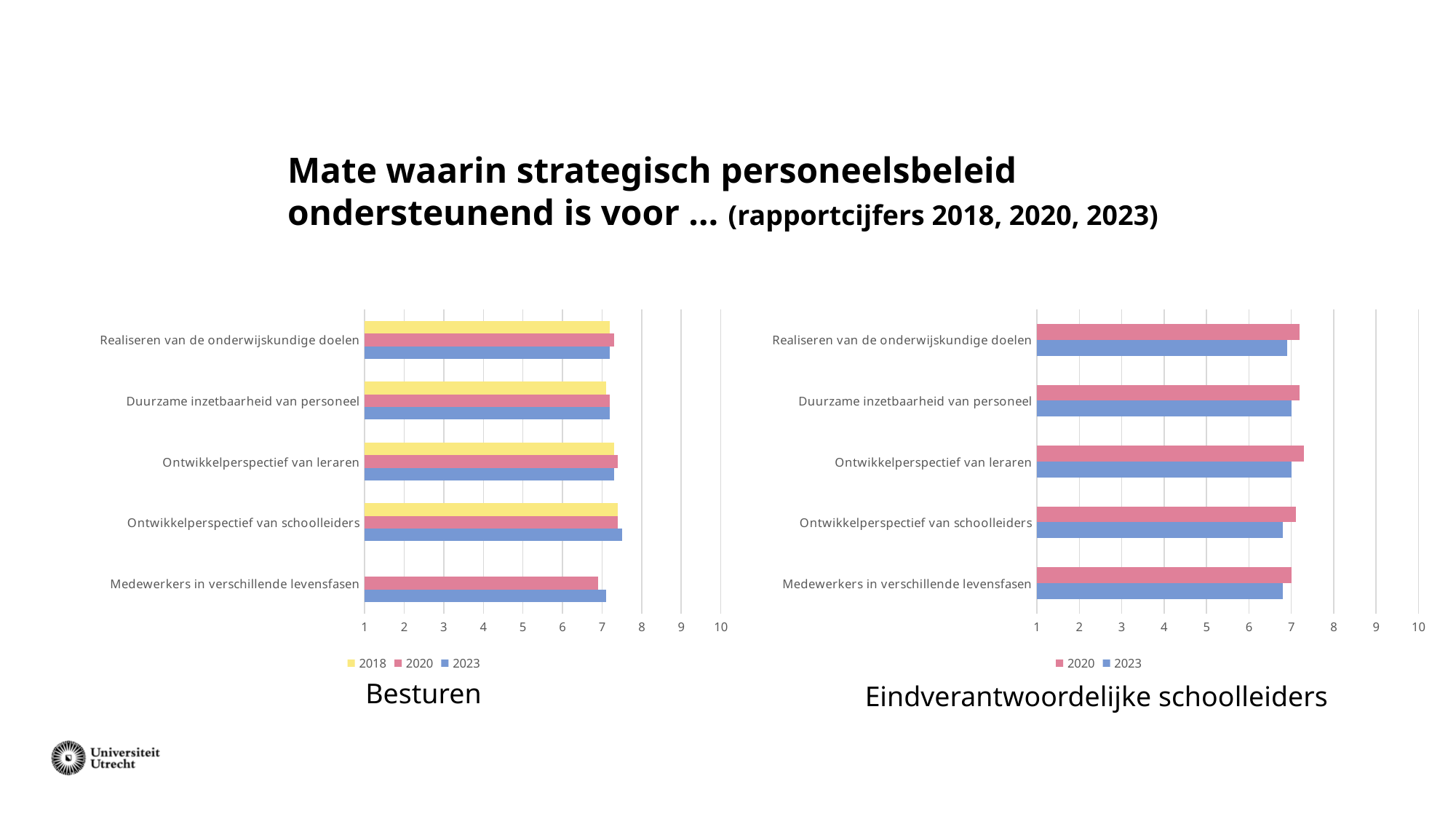
How many series does the legend of the Eindverantwoordelijke schoolleiders chart list? 2 Which years are listed in the legend of the Eindverantwoordelijke schoolleiders chart? 2020 and 2023 In the Eindverantwoordelijke schoolleiders chart, which is larger for Ontwikkelperspectief van leraren: the 2020 value or the 2023 value? 2020 In the Besturen chart, which category has the lowest 2020 value? Medewerkers in verschillende levensfasen In the Besturen chart, which category has no 2018 bar? Medewerkers in verschillende levensfasen In the Besturen chart, is the 2023 value for Ontwikkelperspectief van schoolleiders greater or less than 8? less In the Eindverantwoordelijke schoolleiders chart, is the 2020 value for Ontwikkelperspectief van leraren greater or less than 6? greater How many categories are shown on the Eindverantwoordelijke schoolleiders chart? 5 What is the highest value shown on the x axis of the Besturen chart? 10 What kind of chart is the Besturen chart on the left? bar chart In the Besturen chart, which is larger for Medewerkers in verschillende levensfasen: the 2020 value or the 2023 value? 2023 How many series does the legend of the Besturen chart list? 3